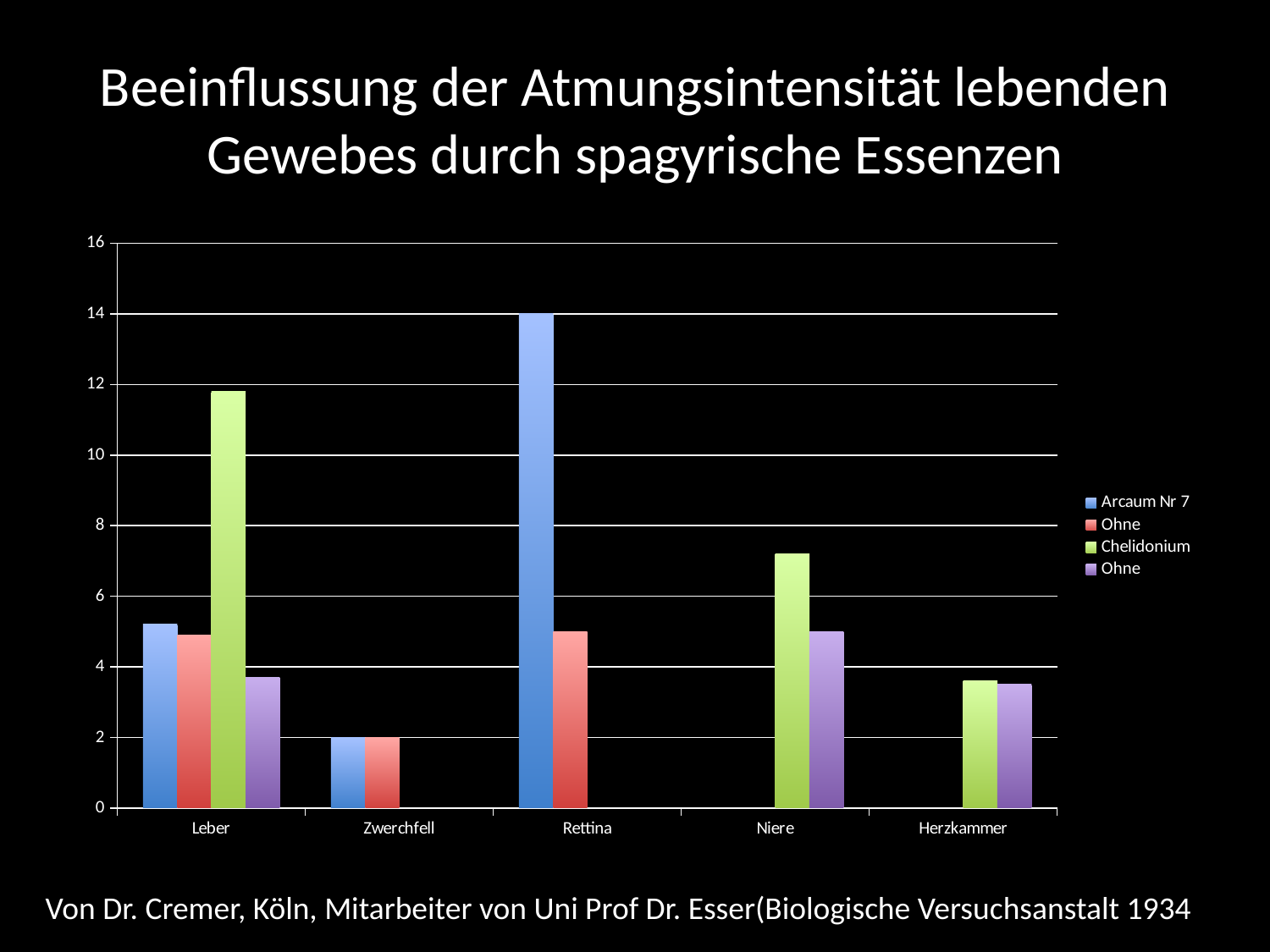
How many categories are shown on the x axis of the chart? 5 How many series does the chart's legend list? 4 Is the Chelidonium value for Leber greater or less than 10? greater For Leber, which is larger: the Chelidonium bar or the Arcaum Nr 7 bar? Chelidonium What type of chart is shown on the slide? bar chart What is the value of the Arcaum Nr 7 bar for Zwerchfell? 2 What is the value of the Arcaum Nr 7 bar for Rettina? 14 Which category has the highest Chelidonium value? Leber Which category has the highest Arcaum Nr 7 value? Rettina Is the Chelidonium value for Niere greater or less than 6? greater Which category has the lowest Chelidonium value among those with a Chelidonium bar? Herzkammer What is the title of the chart on the slide? Beeinflussung der Atmungsintensität lebenden Gewebes durch spagyrische Essenzen